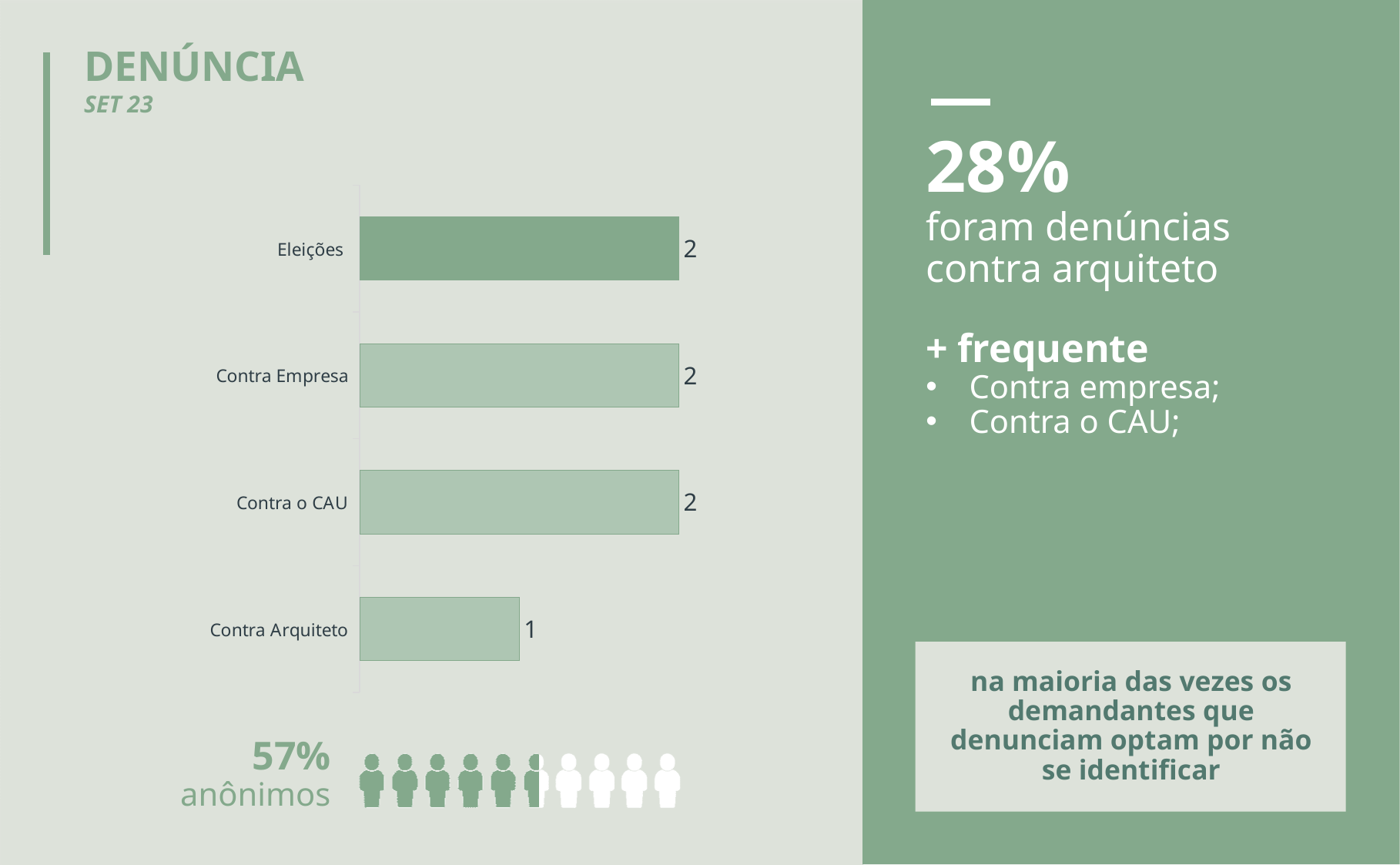
What is the value for Contra Empresa? 2 Which is larger, the value for Contra o CAU or the value for Contra Arquiteto? Contra o CAU What is the value for Eleições? 2 What is the value for Contra Arquiteto? 1 Which category's bar is drawn in the darkest green? Eleições Do the values for Contra Empresa and Contra o CAU differ? No, both are 2 Which category has the lowest value? Contra Arquiteto What is the value for Contra o CAU? 2 How many categories are shown in the bar chart? 4 What is the title of the slide containing the chart? DENÚNCIA What is the difference between the values for Eleições and Contra Arquiteto? 1 What kind of chart is shown on the slide? Bar chart